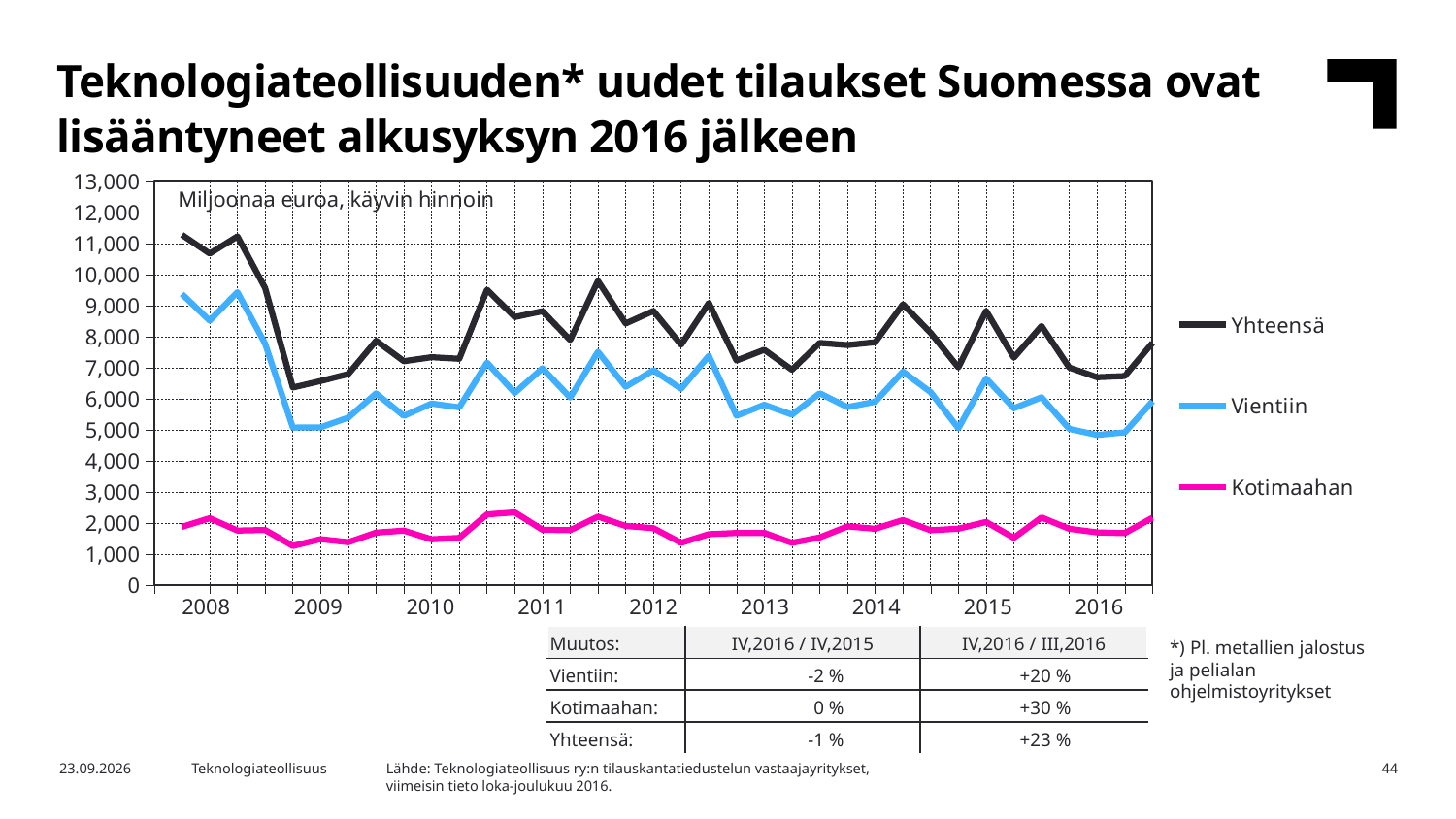
Which series are listed in the legend? Yhteensä, Vientiin, Kotimaahan Which series has the lowest values throughout the chart? Kotimaahan At the end of 2016, which is larger, Vientiin or Kotimaahan? Vientiin Is the value for Kotimaahan at the end of 2016 greater or less than 3,000? less Which series has the highest values throughout the chart? Yhteensä How many series does the legend list? 3 Is the value for Yhteensä at the start of 2008 greater or less than 10,000? greater What unit label is printed inside the chart area? Miljoonaa euroa, käyvin hinnoin Is the value for Vientiin at the end of 2016 greater or less than 5,000? greater Does the Yhteensä series overall rise or fall from 2008 to 2016? fall What kind of chart is shown on the slide? line chart How many years are labelled on the x axis? 9